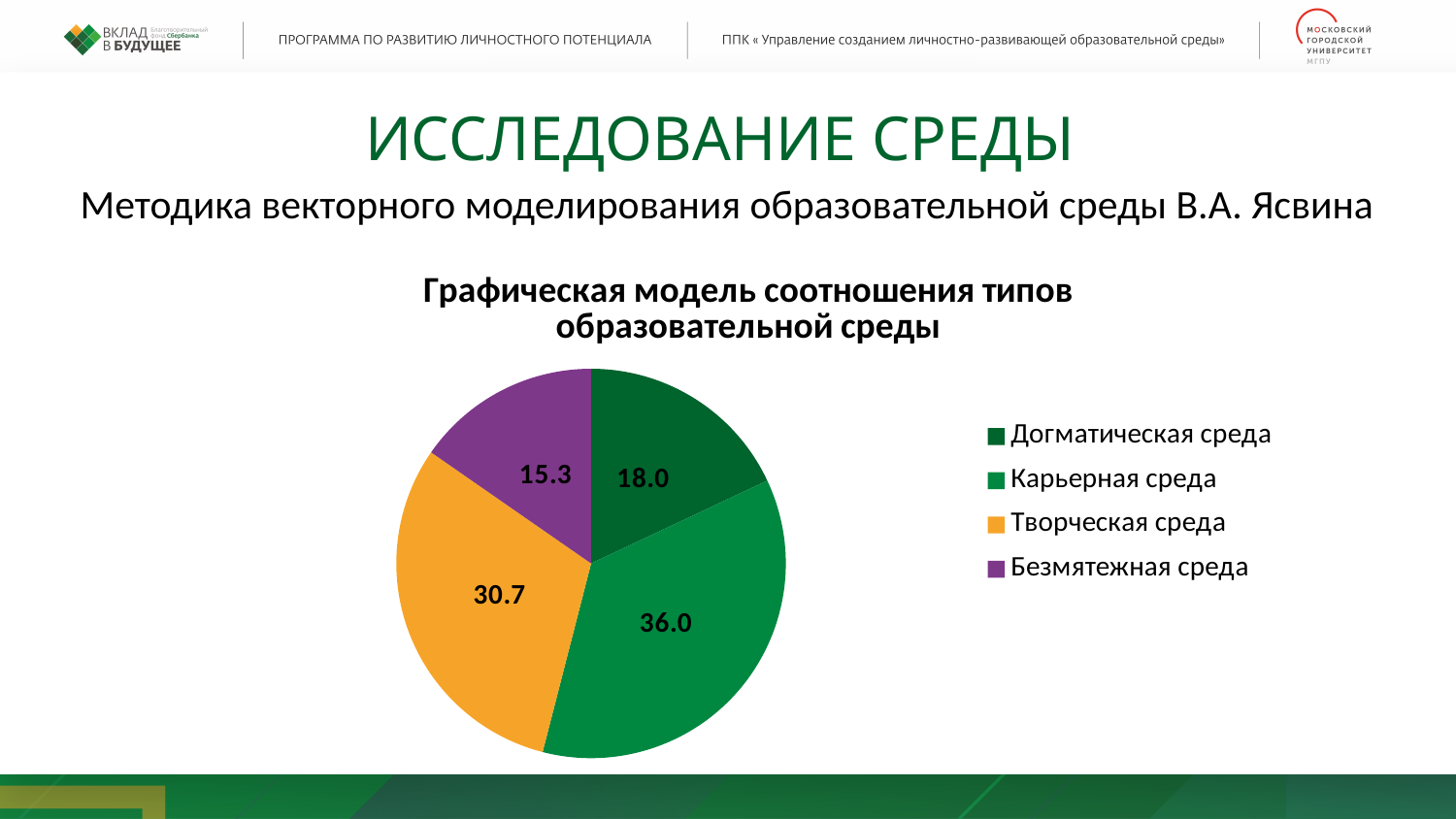
What is the value for Безмятежная среда? 15.3 What is the value for Карьерная среда? 36.0 What is the value for Творческая среда? 30.7 How many slices does the pie chart have? 4 What type of chart is shown on the slide? pie chart Which category has the smallest slice of the pie? Безмятежная среда Which is larger, the value for Догматическая среда or the value for Безмятежная среда? Догматическая среда What share of the whole pie does the Карьерная среда slice represent? 36% What is the difference between the values for Карьерная среда and Творческая среда? 5.3 What is the title of the pie chart? Графическая модель соотношения типов образовательной среды What is the value for Догматическая среда? 18.0 Which category has the largest slice of the pie? Карьерная среда